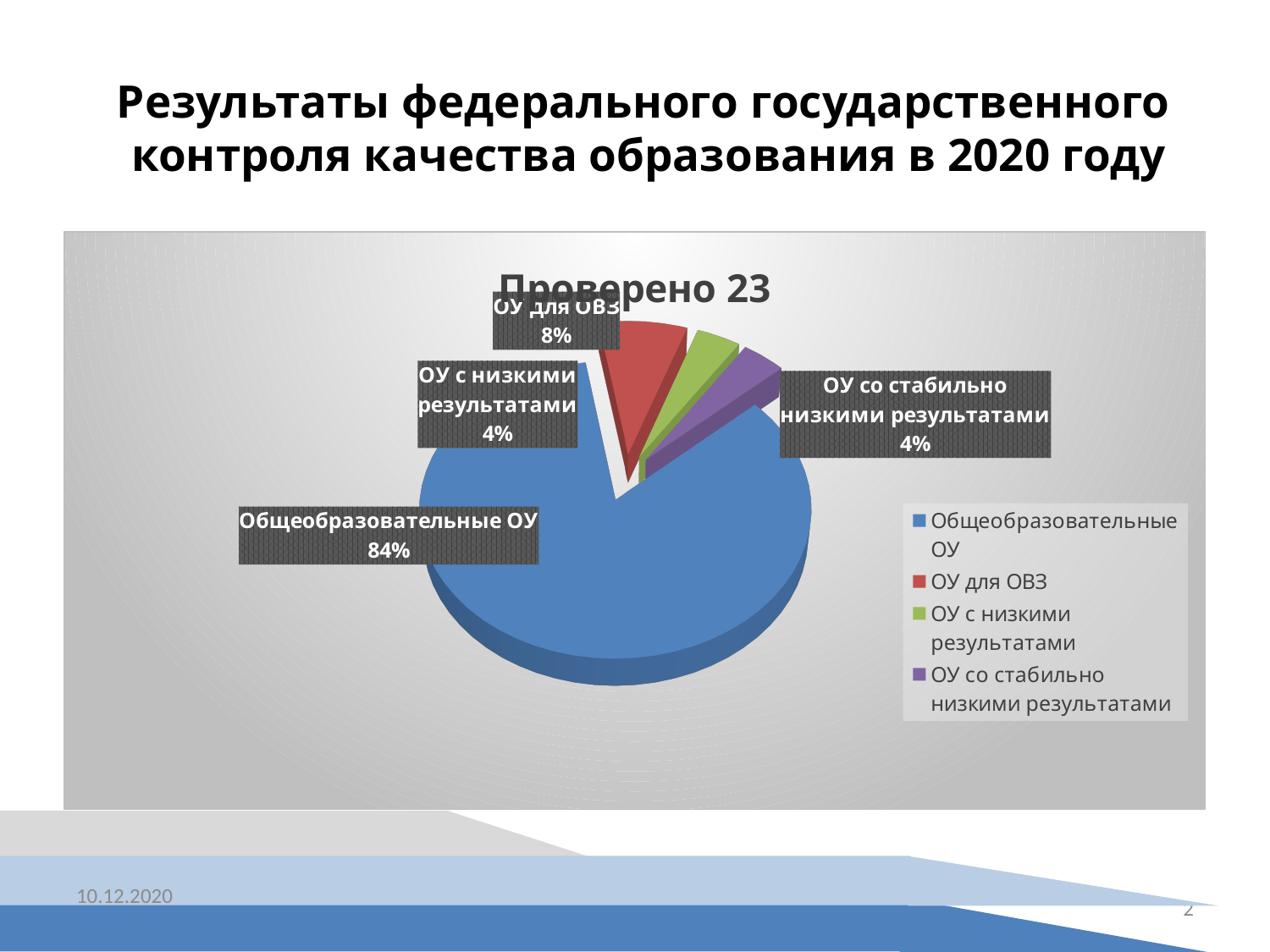
What is the difference in percentage points between the share for Общеобразовательные ОУ and the share for ОУ для ОВЗ? 76 How many entries does the legend list? 4 Which category has the largest slice of the pie? Общеобразовательные ОУ How many slices does the pie chart have? 4 What colour is the slice for Общеобразовательные ОУ? Blue What share of the pie is labelled for ОУ с низкими результатами? 4% What is the title of the chart? Проверено 23 What share of the pie is labelled for ОУ для ОВЗ? 8% What share of the pie is labelled for ОУ со стабильно низкими результатами? 4% Which is larger: the share for ОУ для ОВЗ or the share for ОУ с низкими результатами? ОУ для ОВЗ What type of chart is shown on the slide? Pie chart